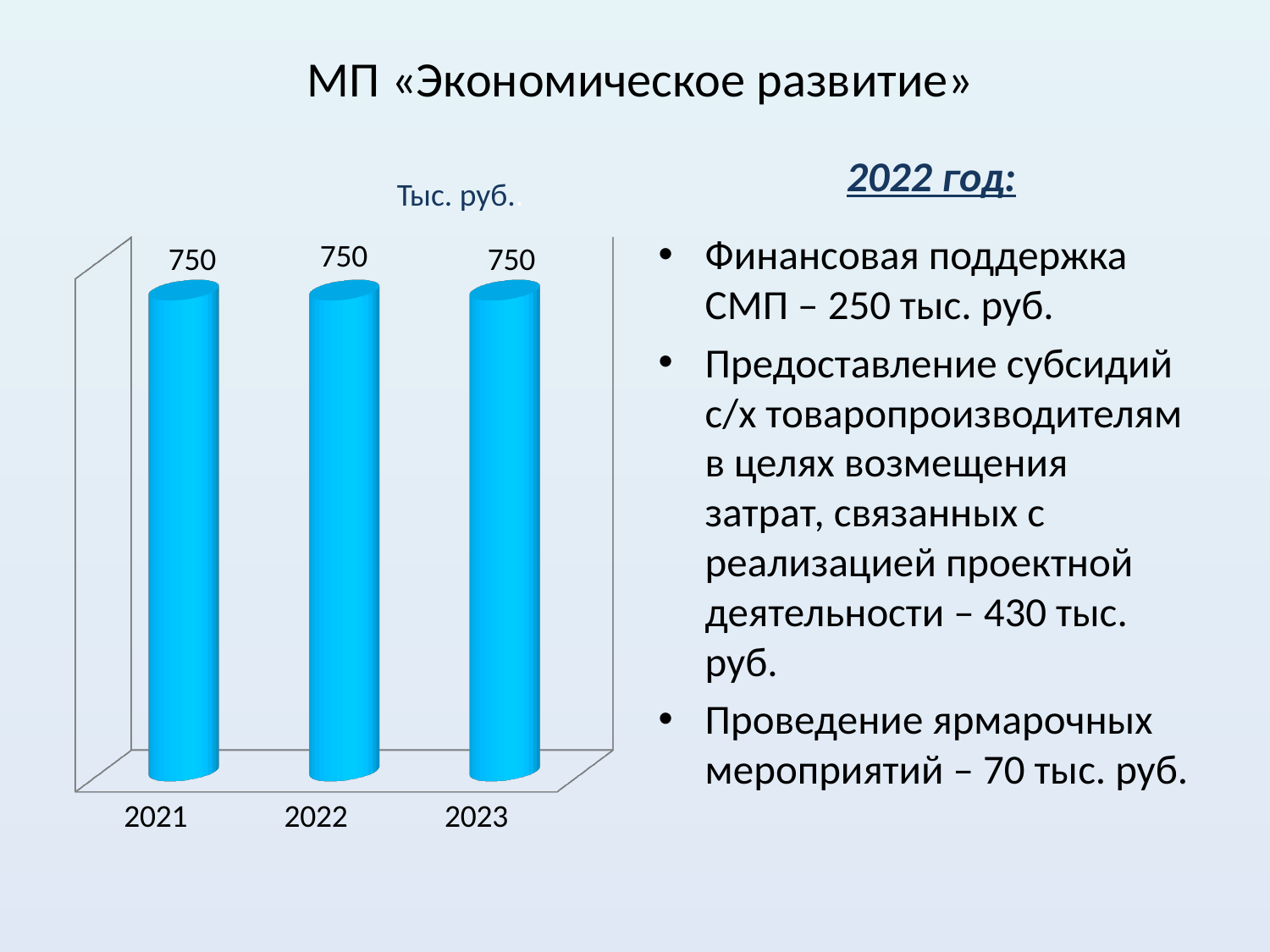
What colour are the bars in the chart? blue What is the difference between the values for 2023 and 2022? 0 What is the difference between the values for 2022 and 2021? 0 What is the value for 2021? 750 What is the value for 2022? 750 What kind of chart is shown on the slide? bar chart What is the value for 2023? 750 How many categories are shown on the x axis of the chart? 3 Which years are shown as categories on the x axis? 2021, 2022, 2023 Do the values rise, fall, or stay the same from 2021 to 2023? stay the same What is the title of the chart? Тыс. руб.